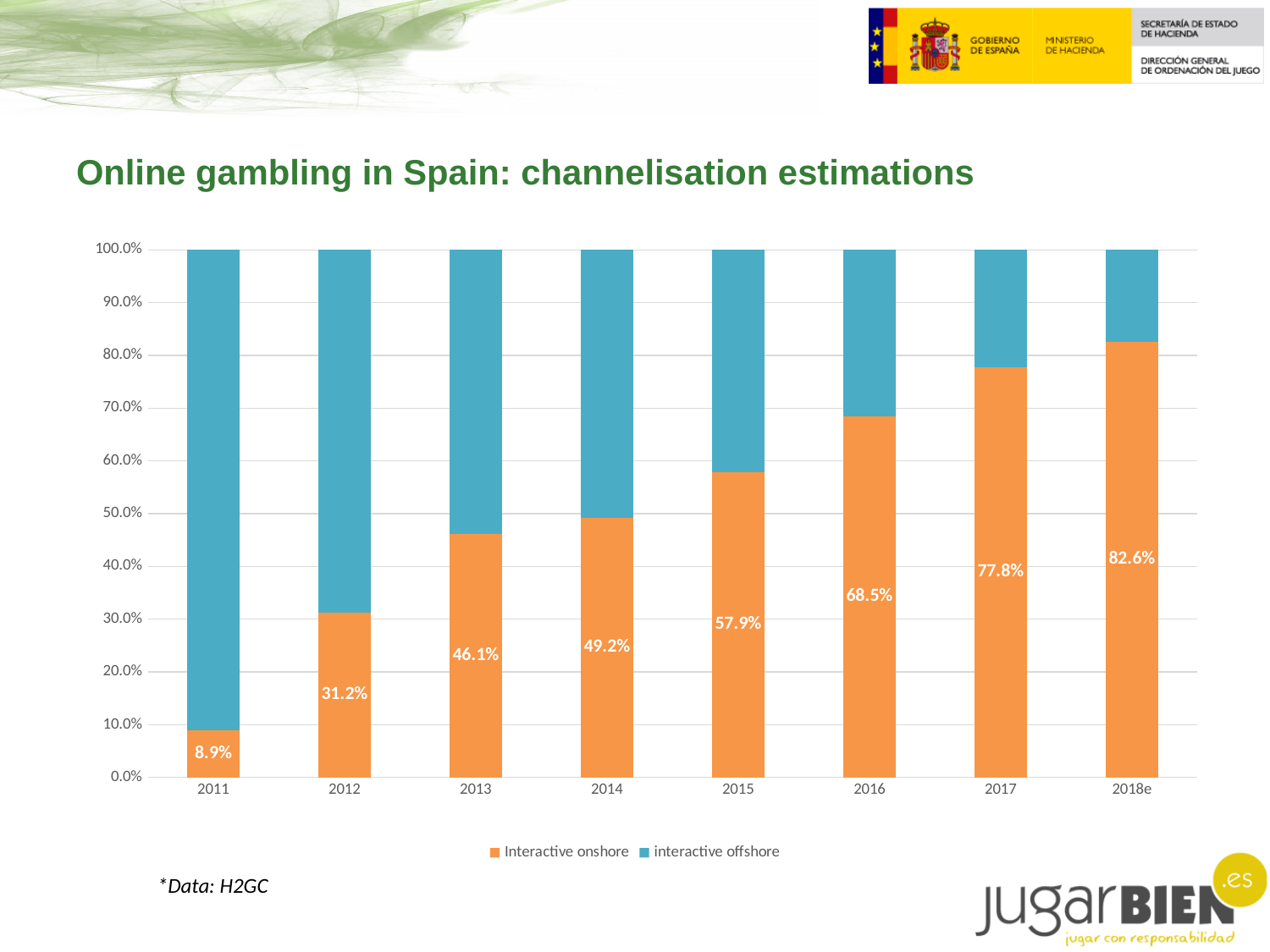
Which is larger, the Interactive onshore value for 2013 or for 2014? 2014 Is the interactive offshore value for 2012 greater or less than 60.0%? greater Which year has the lowest Interactive onshore share? 2011 What is the Interactive onshore value for 2018e? 82.6% What is the difference between the Interactive onshore values for 2017 and 2016? 9.3% Which year has the highest Interactive onshore share? 2018e How many years are shown on the x axis? 8 Does the Interactive onshore share rise or fall from 2011 to 2018e? Rise What is the Interactive onshore value for 2015? 57.9% What kind of chart is shown on the slide? Stacked bar chart How many series does the legend list? 2 What is the Interactive onshore value for 2011? 8.9%